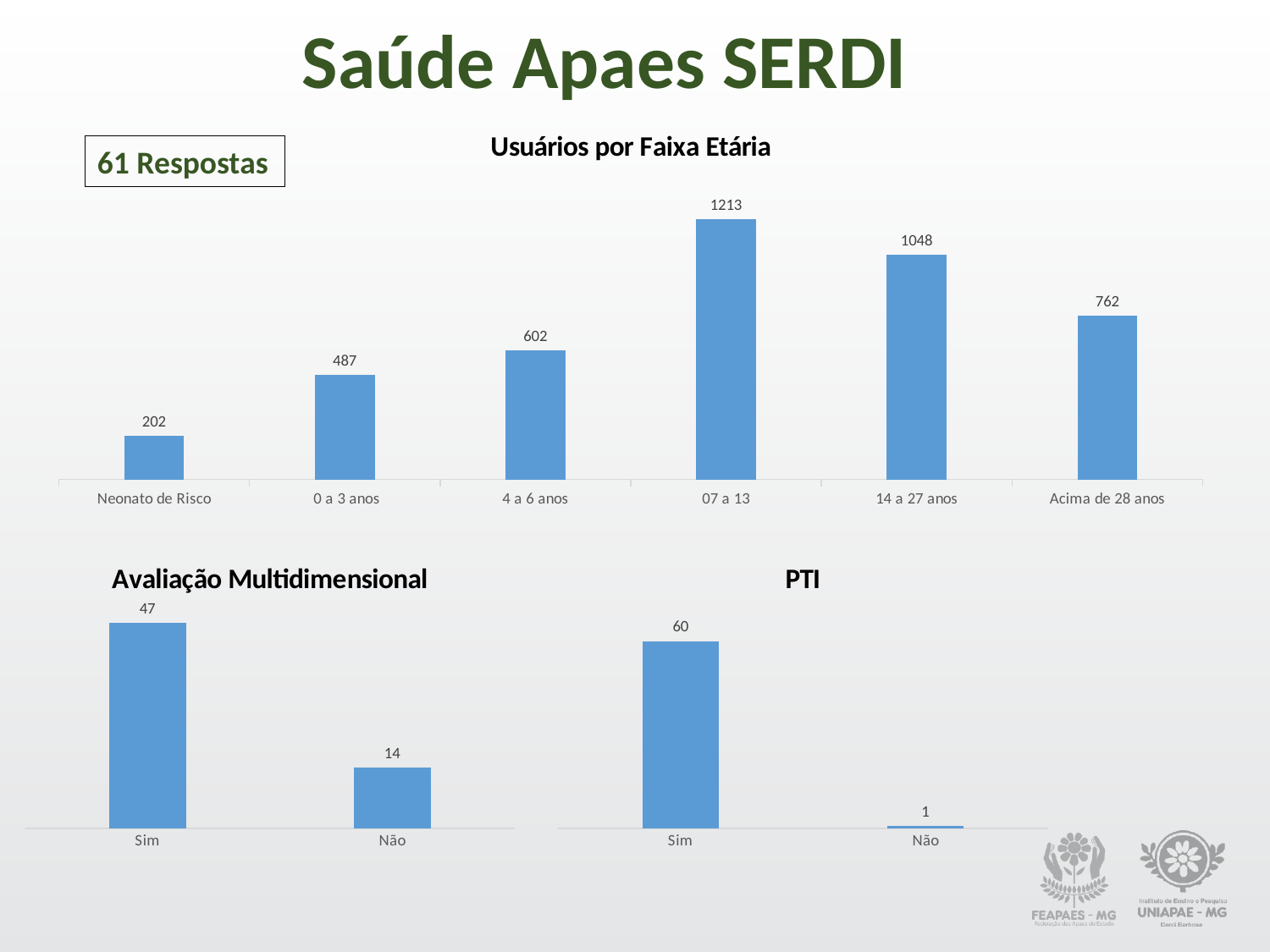
In the 'Usuários por Faixa Etária' chart, what is the value for 'Neonato de Risco'? 202 In the 'Avaliação Multidimensional' chart, what is the difference between 'Sim' and 'Não'? 33 In the 'Avaliação Multidimensional' chart, what is the value for 'Não'? 14 In the 'PTI' chart, which category has the lowest value? Não In the 'Usuários por Faixa Etária' chart, which is larger: '0 a 3 anos' or '4 a 6 anos'? 4 a 6 anos In the 'PTI' chart, what is the value for 'Sim'? 60 In the 'Usuários por Faixa Etária' chart, what is the difference between '14 a 27 anos' and 'Acima de 28 anos'? 286 In the 'Usuários por Faixa Etária' chart, which category has the highest value? 07 a 13 In the 'Usuários por Faixa Etária' chart, what is the value for '07 a 13'? 1213 What kind of chart is 'Usuários por Faixa Etária'? bar chart How many categories are shown in the 'Usuários por Faixa Etária' chart? 6 In the 'Usuários por Faixa Etária' chart, which category has the lowest value? Neonato de Risco